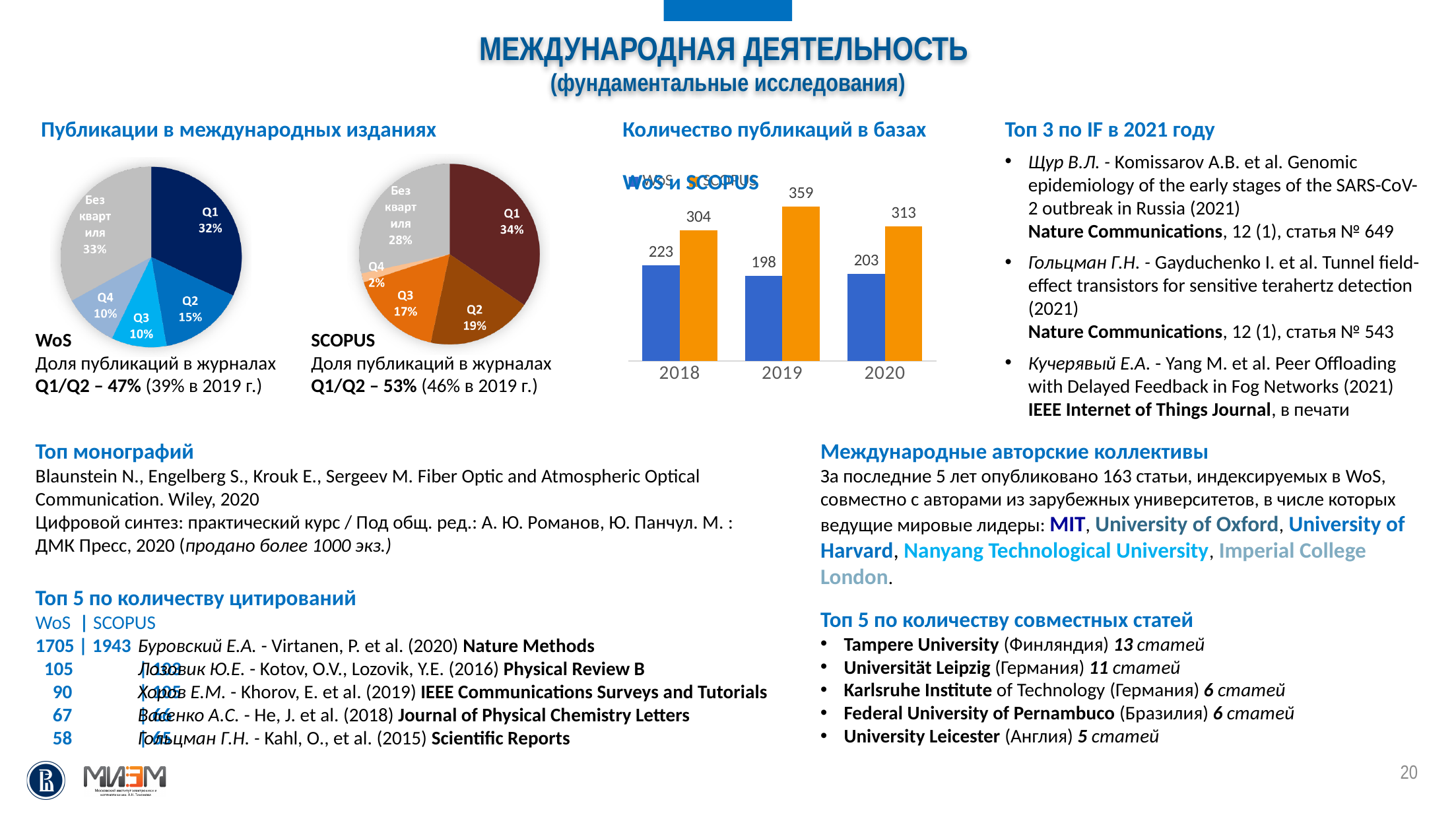
In the WoS pie chart, which category has the largest share? Без квартиля In the SCOPUS pie chart, what is the difference between the Q1 share and the Q2 share? 15% What type of chart is 'Количество публикаций в базах WoS и SCOPUS'? bar chart In the SCOPUS pie chart, which category has the smallest share? Q4 In the bar chart 'Количество публикаций в базах WoS и SCOPUS', how many years are shown on the x axis? 3 In the bar chart 'Количество публикаций в базах WoS и SCOPUS', which year has the highest orange bar? 2019 In the bar chart 'Количество публикаций в базах WoS и SCOPUS', what is the difference between the orange and blue bars in 2020? 110 In the bar chart 'Количество публикаций в базах WoS и SCOPUS', what is the value of the orange bar for 2019? 359 In the bar chart 'Количество публикаций в базах WoS и SCOPUS', what is the value of the blue bar for 2018? 223 How many slices does the WoS pie chart have? 5 In the SCOPUS pie chart, what share of publications is in Q4? 2% In the WoS pie chart, what share of publications is in Q1? 32%